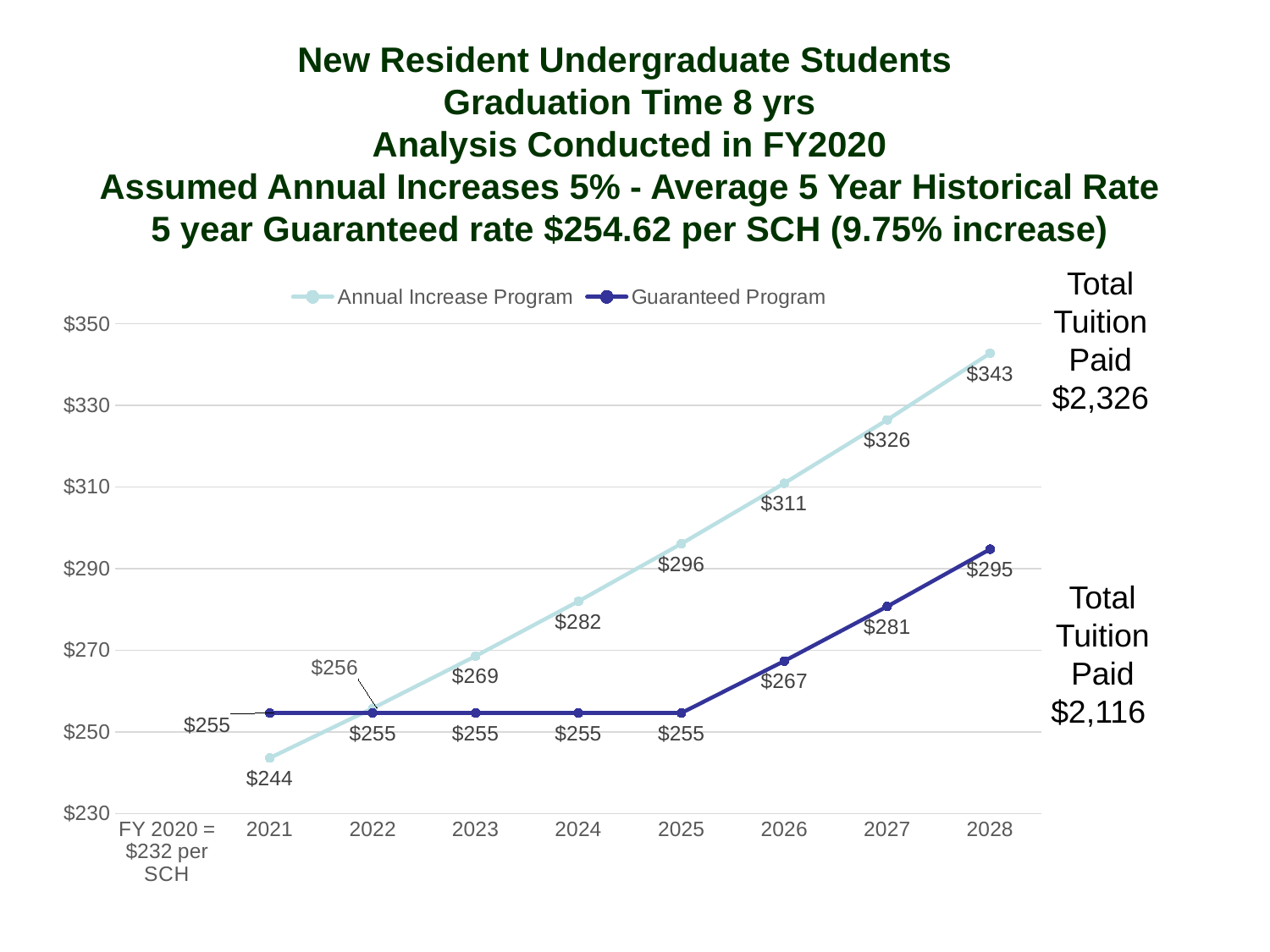
What is the value for the Annual Increase Program in 2028? $343 What is the difference between the Annual Increase Program and the Guaranteed Program values in 2028? $48 What kind of chart is shown on the slide? Line chart What is the value for the Guaranteed Program in 2024? $255 How many series does the legend list? 2 What is the value for the Annual Increase Program in 2021? $244 Does the Annual Increase Program value rise or fall from 2021 to 2028? Rise Is the Annual Increase Program value in 2026 greater or less than $310? greater What is the value for the Guaranteed Program in 2026? $267 In which year is the Annual Increase Program value lowest? 2021 In which year is the Guaranteed Program value highest? 2028 Which series has the larger value in 2021, Annual Increase Program or Guaranteed Program? Guaranteed Program